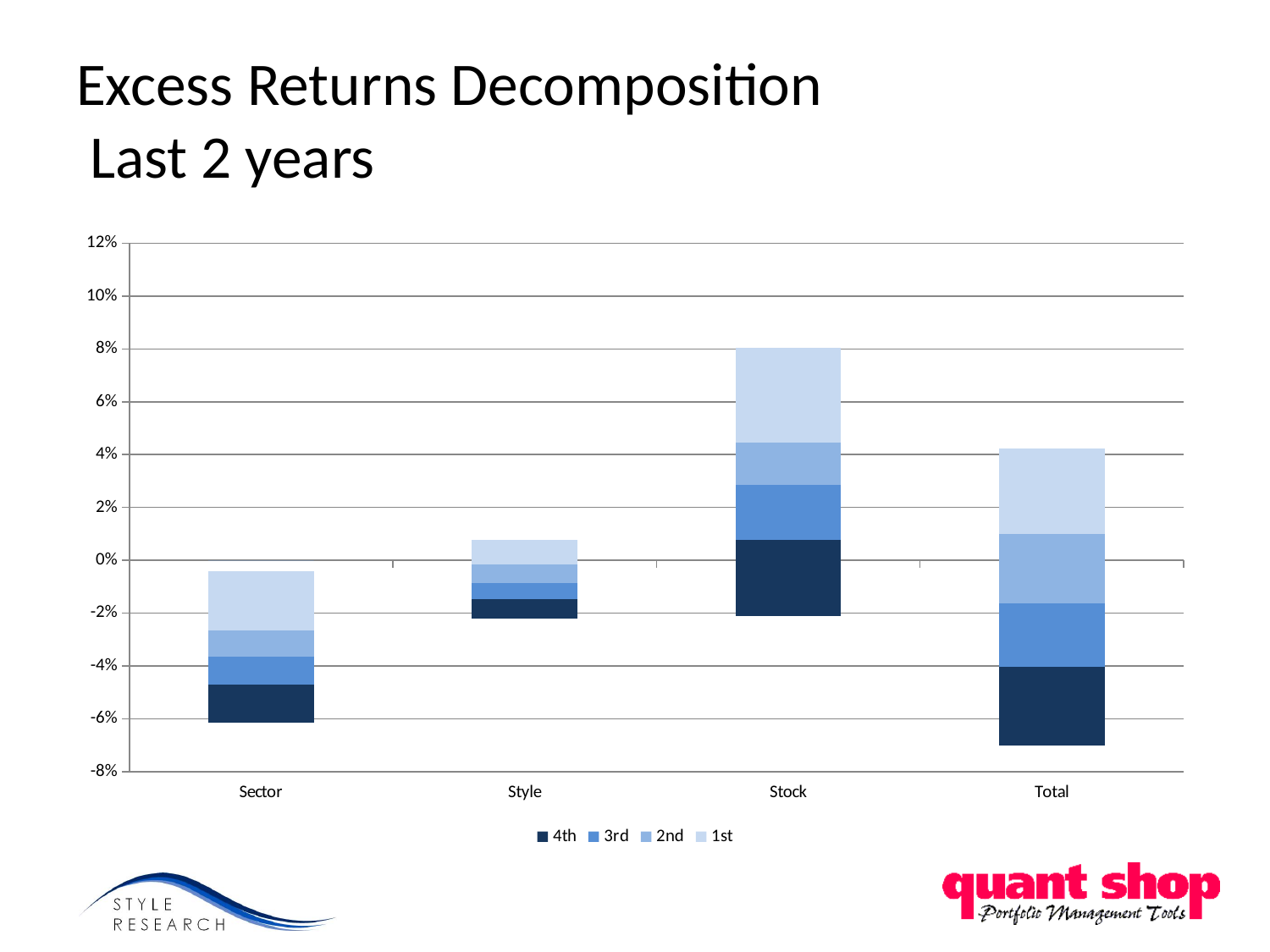
Is the bottom of the Total bar greater or less than -6%? less Which bar reaches higher on the y axis, Stock or Total? Stock Which category's bar extends to the lowest point on the y axis? Total Is the top of the Stock bar greater or less than 6%? greater How many categories are shown on the x axis? 4 Is the bottom of the Sector bar greater or less than -4%? less Which series is shown in the darkest blue in the legend? 4th What is the title of the slide containing the chart? Excess Returns Decomposition Last 2 years What kind of chart is shown on the slide? Stacked bar chart Which category's bar reaches the highest point on the y axis? Stock How many series does the legend list? 4